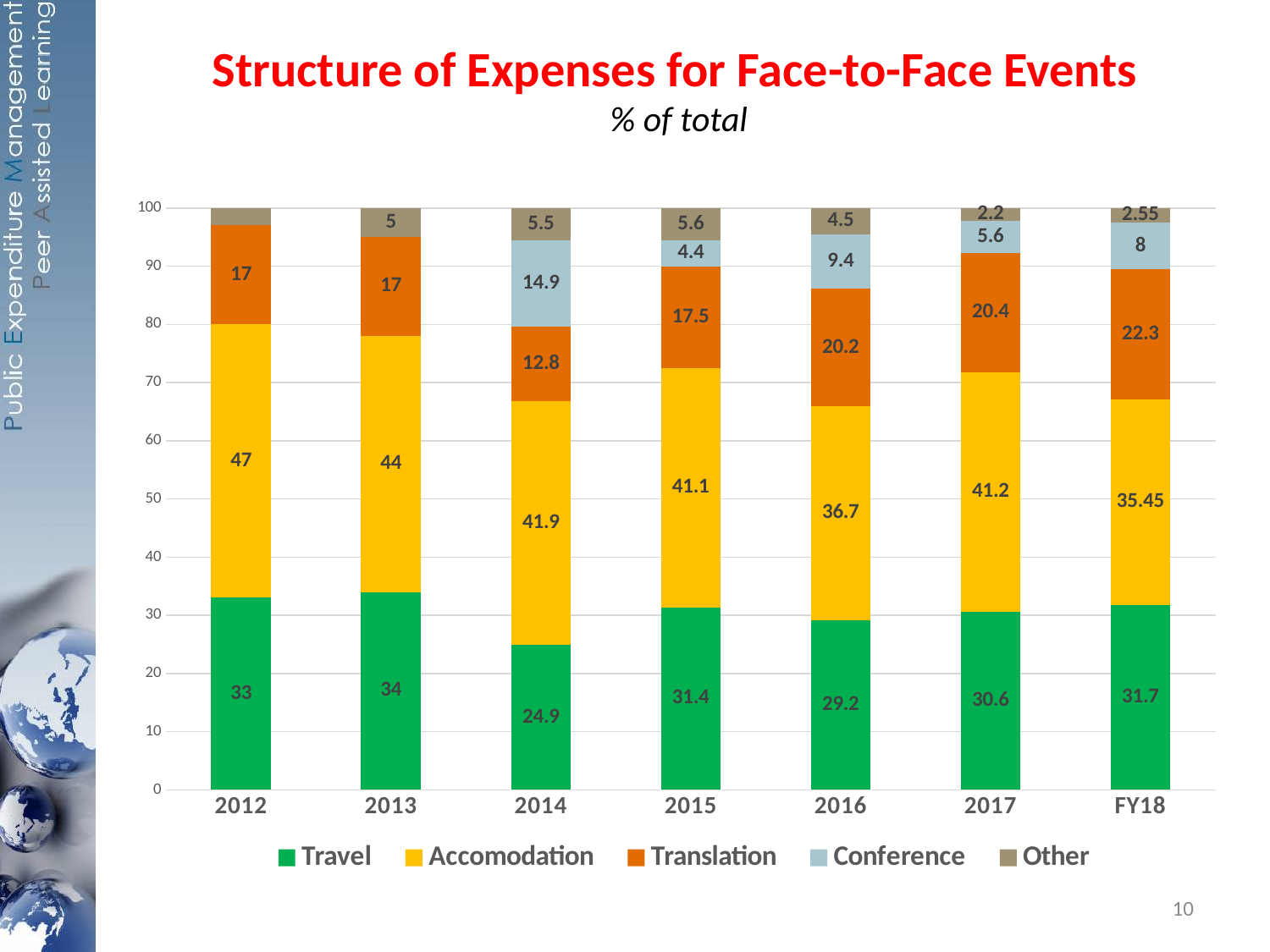
What is the total of the stacked bar for 2017? 100 How many years (categories) are shown on the x axis? 7 What is the difference between the Translation value for FY18 and for 2012? 5.3 What kind of chart is shown on the slide? Stacked bar chart What is the Other value for 2017? 2.2 How many series does the legend list? 5 Does the Translation value rise or fall from 2014 to FY18? Rise In which year is the Travel share lowest? 2014 What is the Travel value for 2014? 24.9 In which year is the Accomodation share highest? 2012 What is the Accomodation value for FY18? 35.45 Which year has the larger Conference value, 2014 or 2016? 2014